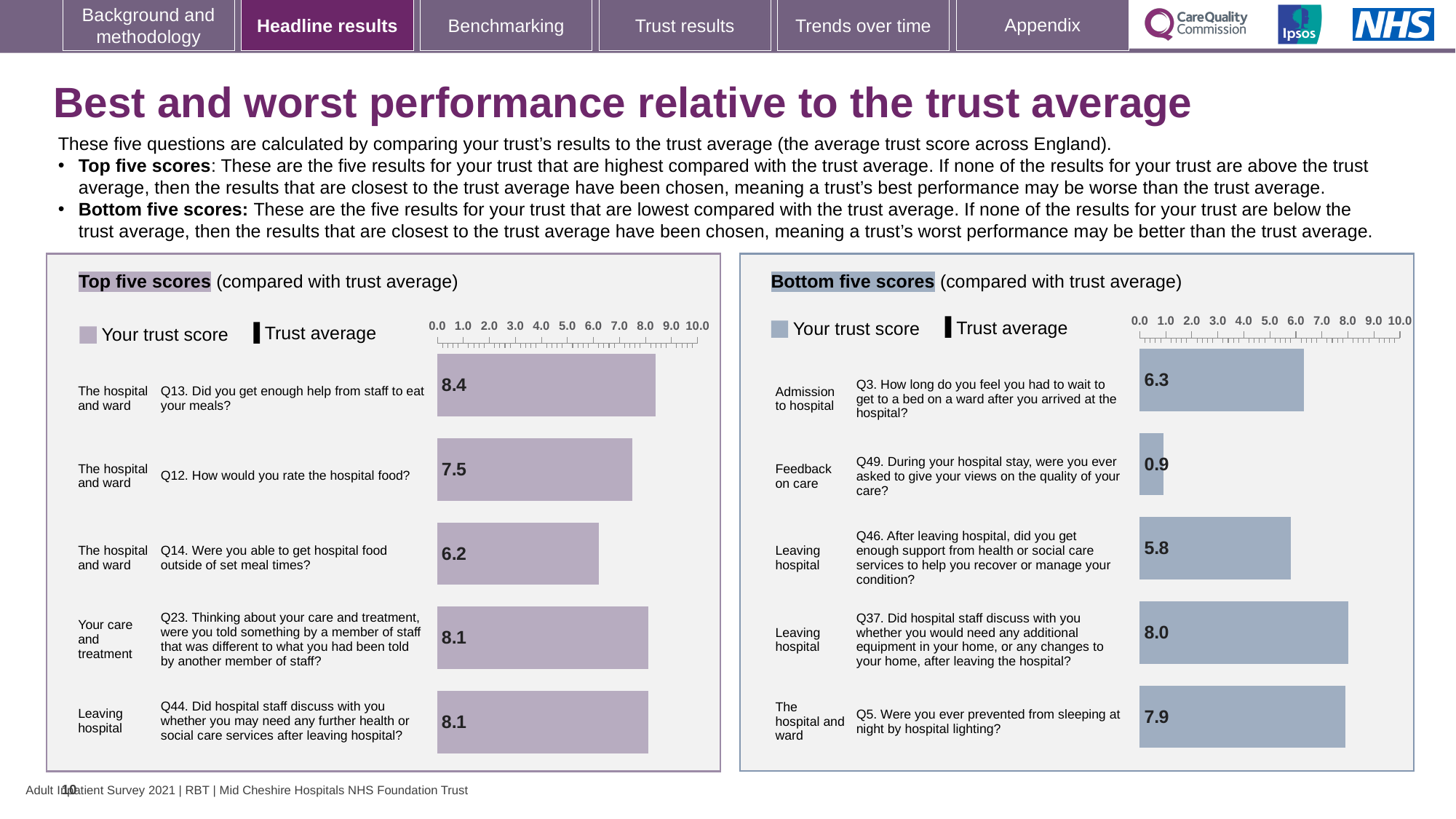
In the Top five scores chart, what is the trust score for Q12 (How would you rate the hospital food?)? 7.5 In the Top five scores chart, which question has the highest trust score? Q13 How many questions are shown in the Bottom five scores chart? 5 In the Bottom five scores chart, what is the trust score for Q49 (were you ever asked to give your views on the quality of your care?)? 0.9 What kind of chart is the Top five scores chart? Bar chart In the Bottom five scores chart, what is the difference between the scores for Q3 and Q46? 0.5 In the Bottom five scores chart, what is the trust score for Q5 (Were you ever prevented from sleeping at night by hospital lighting?)? 7.9 In the Bottom five scores chart, which has the larger score, Q3 or Q46? Q3 In the Top five scores chart, which question has the lowest trust score? Q14 In the Top five scores chart, what is the difference between the scores for Q13 and Q12? 0.9 In the Top five scores chart, what is the trust score for Q13 (Did you get enough help from staff to eat your meals?)? 8.4 In the Bottom five scores chart, which question has the lowest trust score? Q49